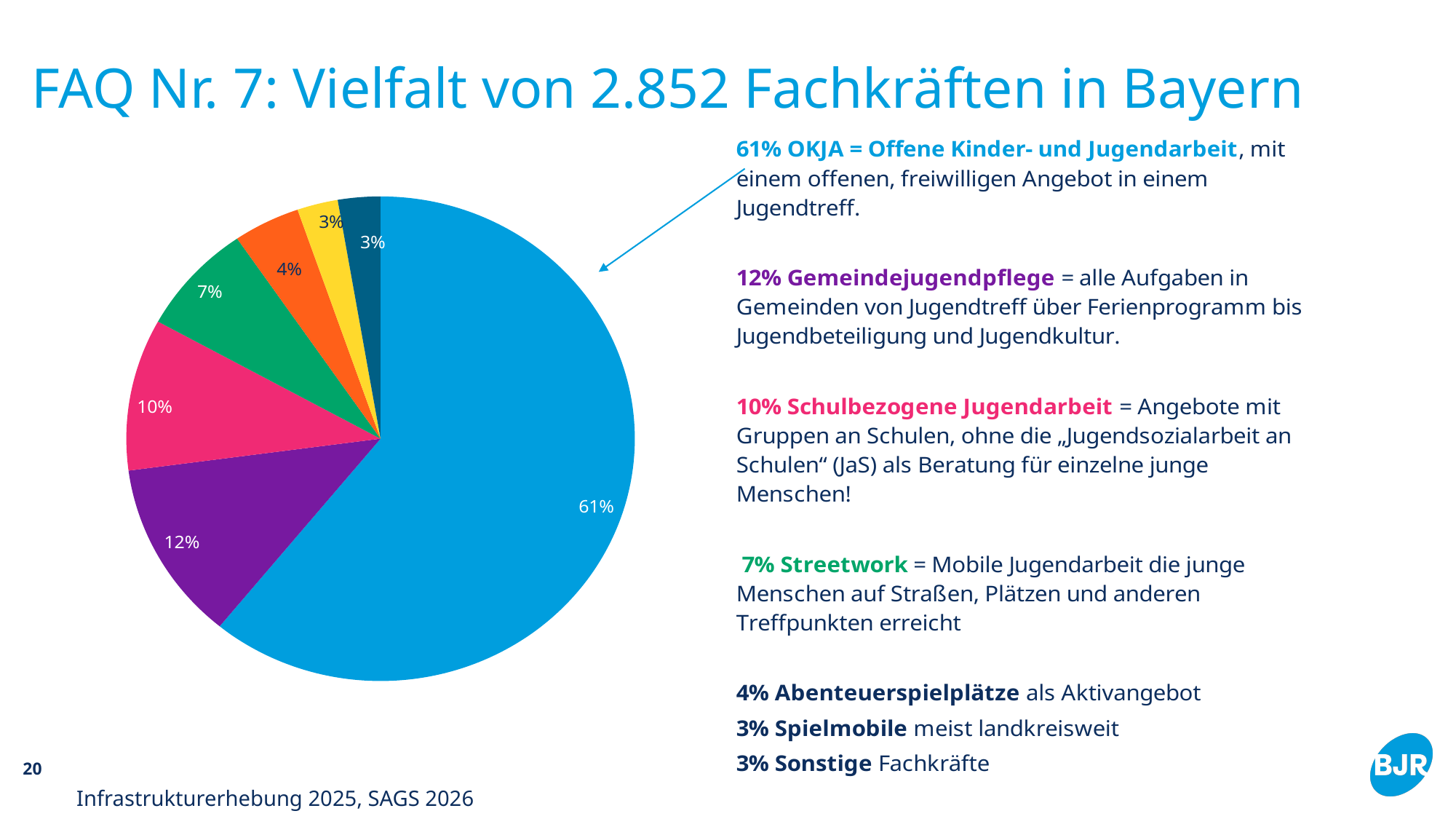
What is the difference in percentage points between OKJA and Gemeindejugendpflege? 49 What share of the pie does OKJA (Offene Kinder- und Jugendarbeit) account for? 61% Which category has the largest slice of the pie? OKJA (Offene Kinder- und Jugendarbeit) What percentage is shown for Schulbezogene Jugendarbeit? 10% What percentage is shown for Streetwork? 7% What kind of chart is shown on the slide? pie chart What percentage is shown for Abenteuerspielplätze? 4% Which is larger, the share for Streetwork or the share for Abenteuerspielplätze? Streetwork What percentage is shown for Gemeindejugendpflege? 12% How many slices does the pie chart have? 7 What colour is the slice representing Gemeindejugendpflege? purple What is the difference in percentage points between Schulbezogene Jugendarbeit and Streetwork? 3